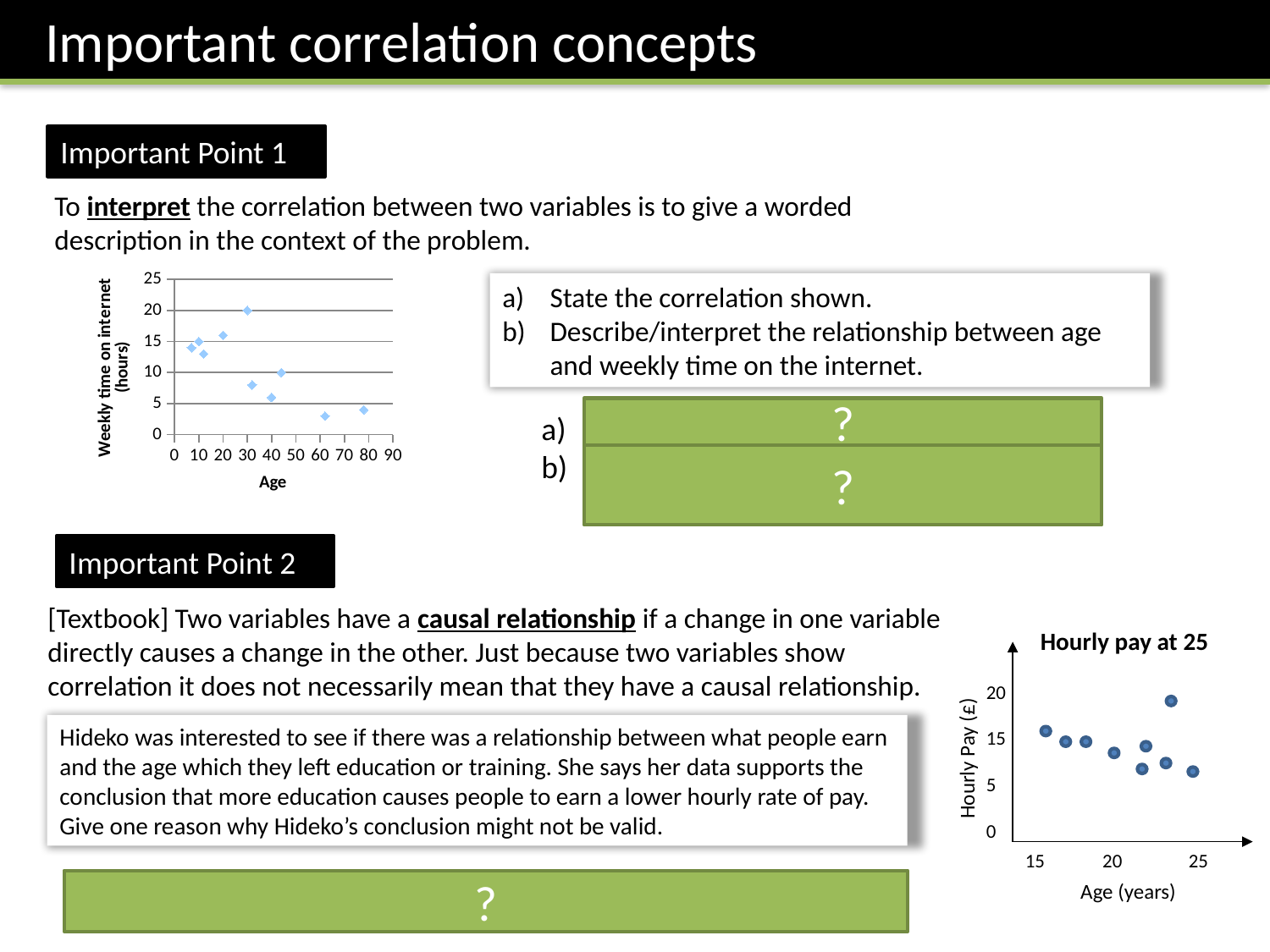
What is the y-axis label of the top-left chart? Weekly time on internet (hours) What is the title of the chart in the bottom-right of the slide? Hourly pay at 25 In the top-left chart, is the highest plotted weekly time on the internet greater or less than 15? greater In the top-left chart, does weekly time on the internet generally rise or fall as age increases? fall In the top-left chart, is the weekly time on the internet for the point at age 30 greater or less than 15? greater In the 'Hourly pay at 25' chart, is the hourly pay for the point at age 25 greater or less than 15? less In the 'Hourly pay at 25' chart, does hourly pay generally rise or fall as age increases? fall What kind of chart is the top-left chart of weekly time on the internet against age? scatter chart What kind of chart is the 'Hourly pay at 25' chart? scatter chart How many data points are plotted in the top-left chart of weekly time on the internet against age? 10